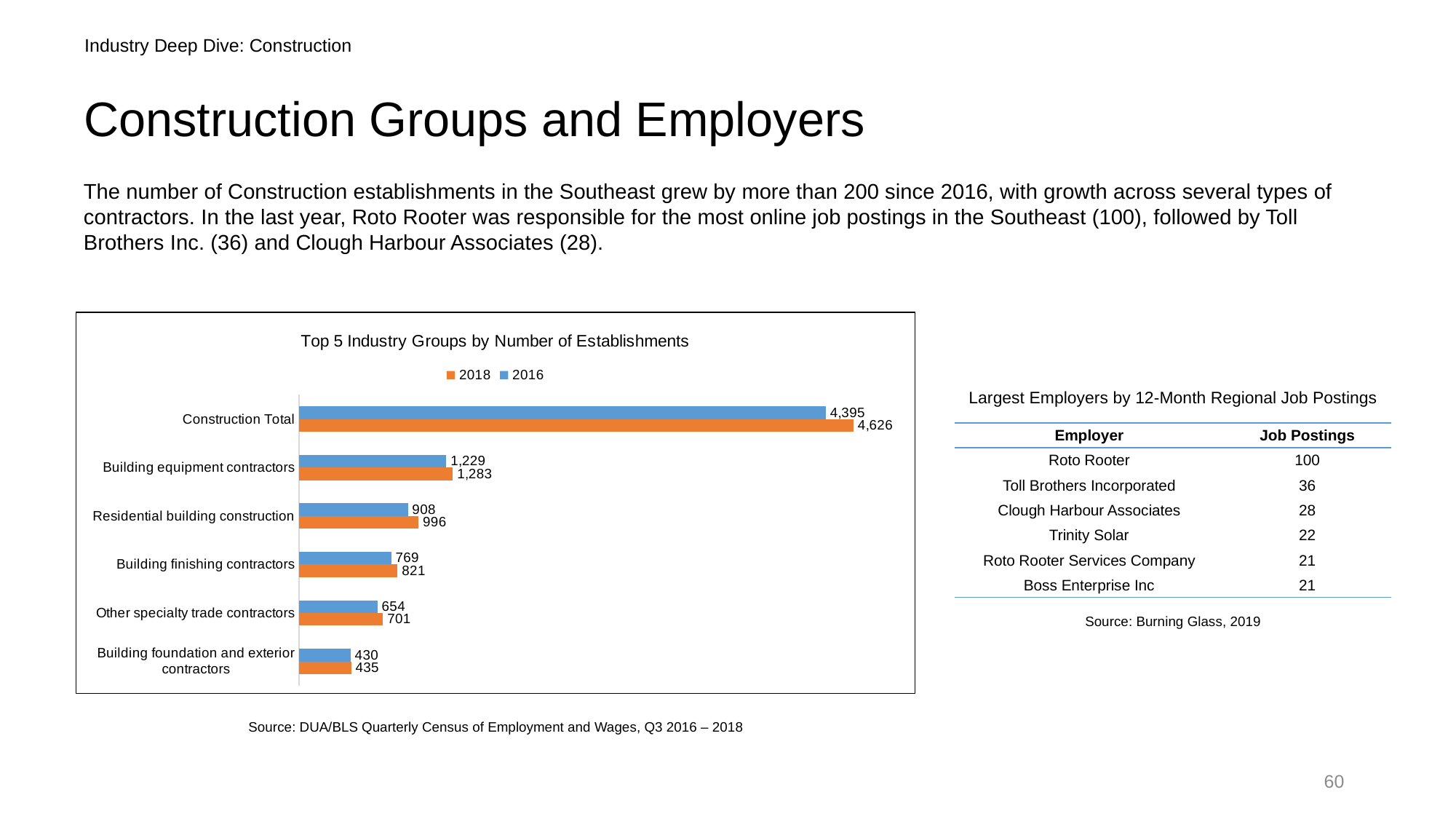
Which is larger for Residential building construction, the 2018 value or the 2016 value? 2018 What is the difference between the 2018 and 2016 values for Building finishing contractors? 52 What is the 2018 value for Construction Total? 4,626 What kind of chart is shown? Bar chart What is the difference between the 2018 and 2016 values for Construction Total? 231 How many series does the legend list? 2 Excluding Construction Total, which category has the highest 2018 value? Building equipment contractors How many categories are shown on the chart? 6 What is the 2018 value for Other specialty trade contractors? 701 Which category has the lowest 2016 value? Building foundation and exterior contractors What is the 2016 value for Building foundation and exterior contractors? 430 What is the 2016 value for Residential building construction? 908